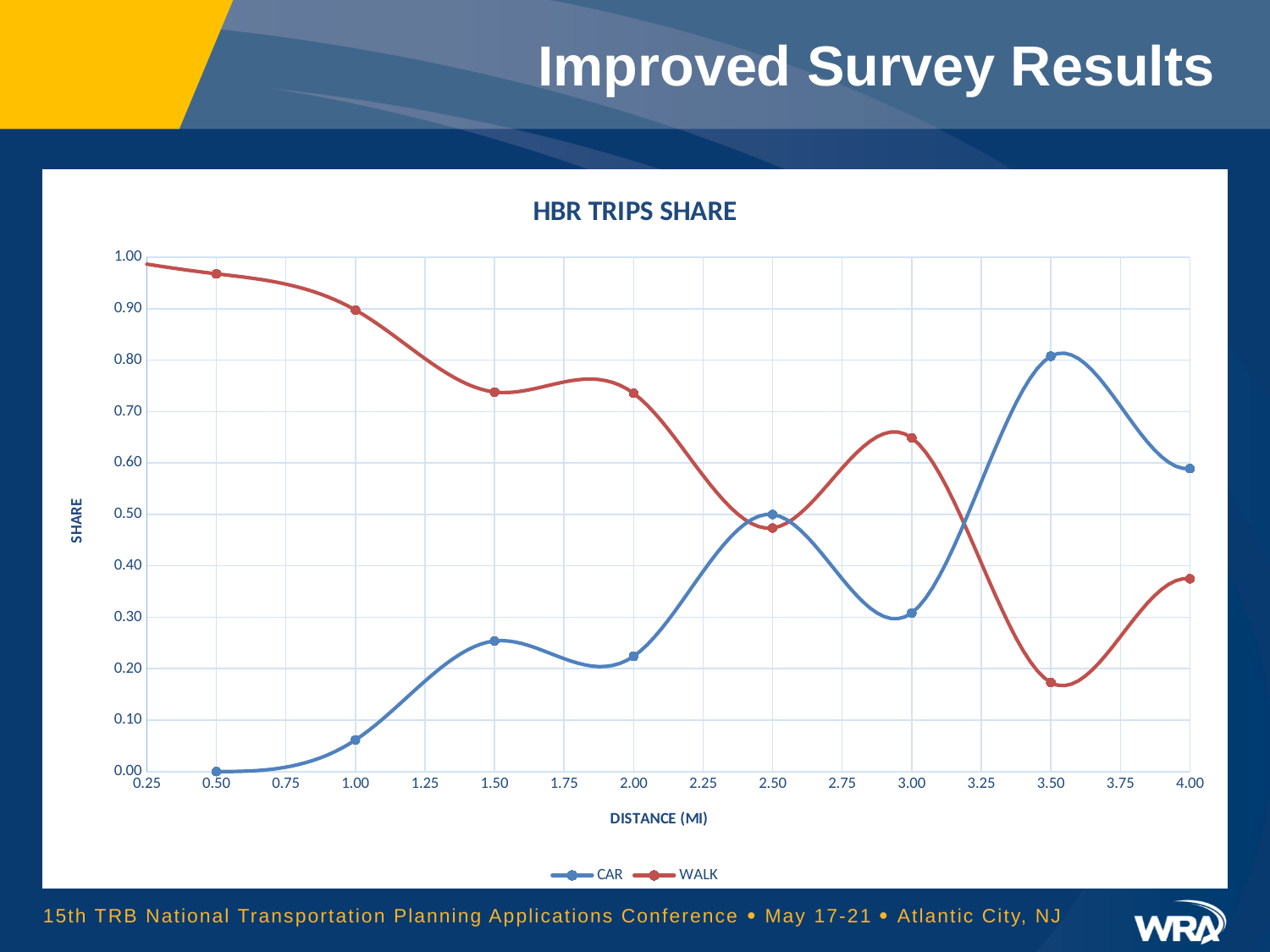
Is the CAR share at 1.00 mile greater or less than 0.10? less At which distance is the WALK share lowest? 3.50 How many data points are plotted for the CAR series? 8 What kind of chart is shown on the slide? line chart At a distance of 2.00 miles, which series has the larger share, CAR or WALK? WALK What is the title of the chart? HBR TRIPS SHARE What is the label of the x axis? DISTANCE (MI) At which distance is the WALK share highest? 0.50 Is the WALK share at 0.50 miles greater or less than 0.90? greater What is the CAR share at a distance of 0.50 miles? 0.00 How many series does the legend list? 2 At which distance is the CAR share highest? 3.50